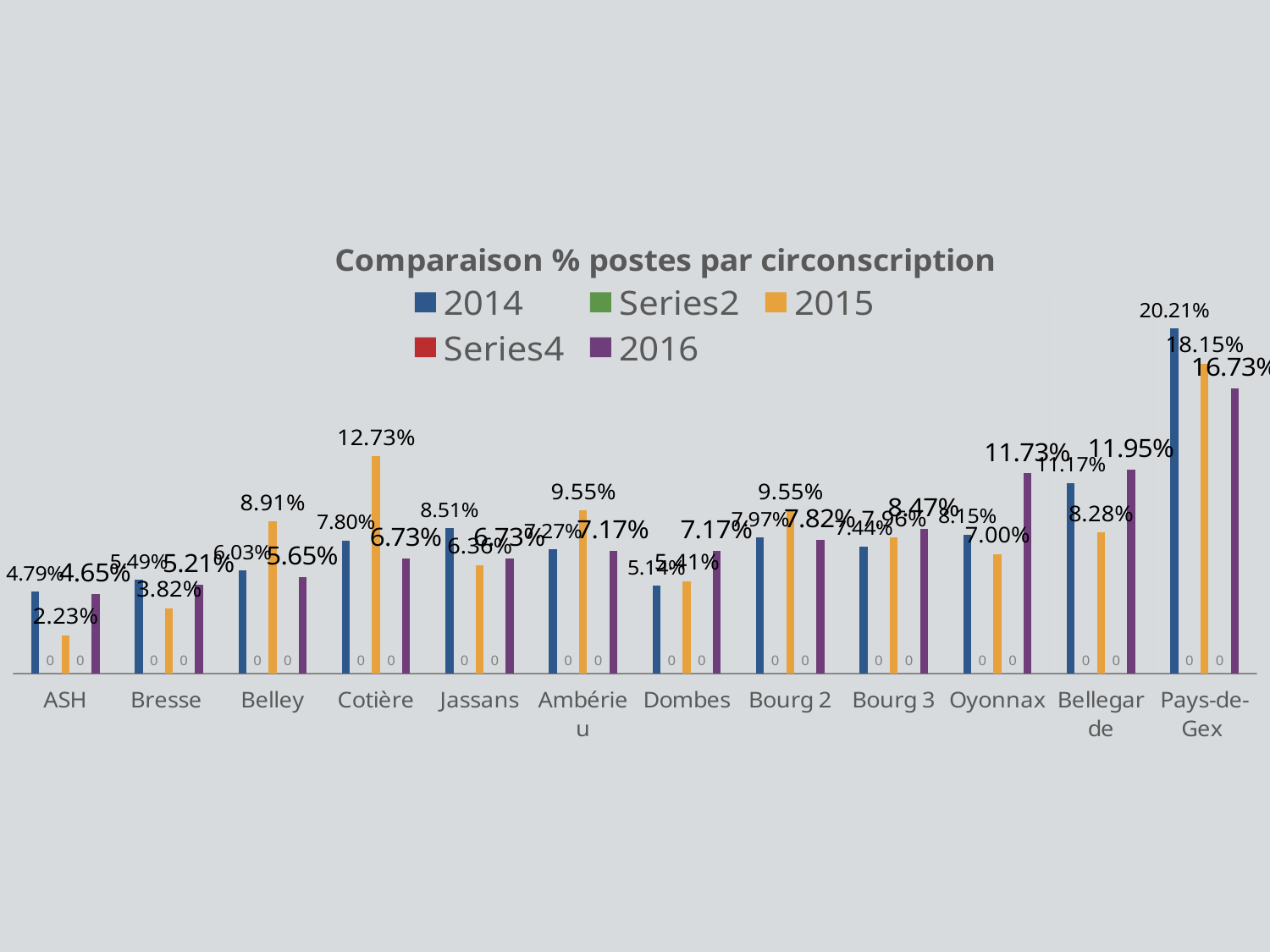
What is the difference between the 2014 and 2015 values for Pays-de-Gex? 2.06% Which circonscription has the lowest 2015 value? ASH What is the 2016 value for Oyonnax? 11.73% How many circonscriptions (categories) are shown on the x axis? 12 What is the 2014 value for Pays-de-Gex? 20.21% How many series does the legend list? 5 What is the title of the chart? Comparaison % postes par circonscription Which circonscription has the highest 2015 value? Pays-de-Gex What kind of chart is shown on the slide? bar chart What is the 2015 value for Cotière? 12.73% Which is larger for Belley: the 2015 value or the 2016 value? 2015 What is the 2015 value for ASH? 2.23%